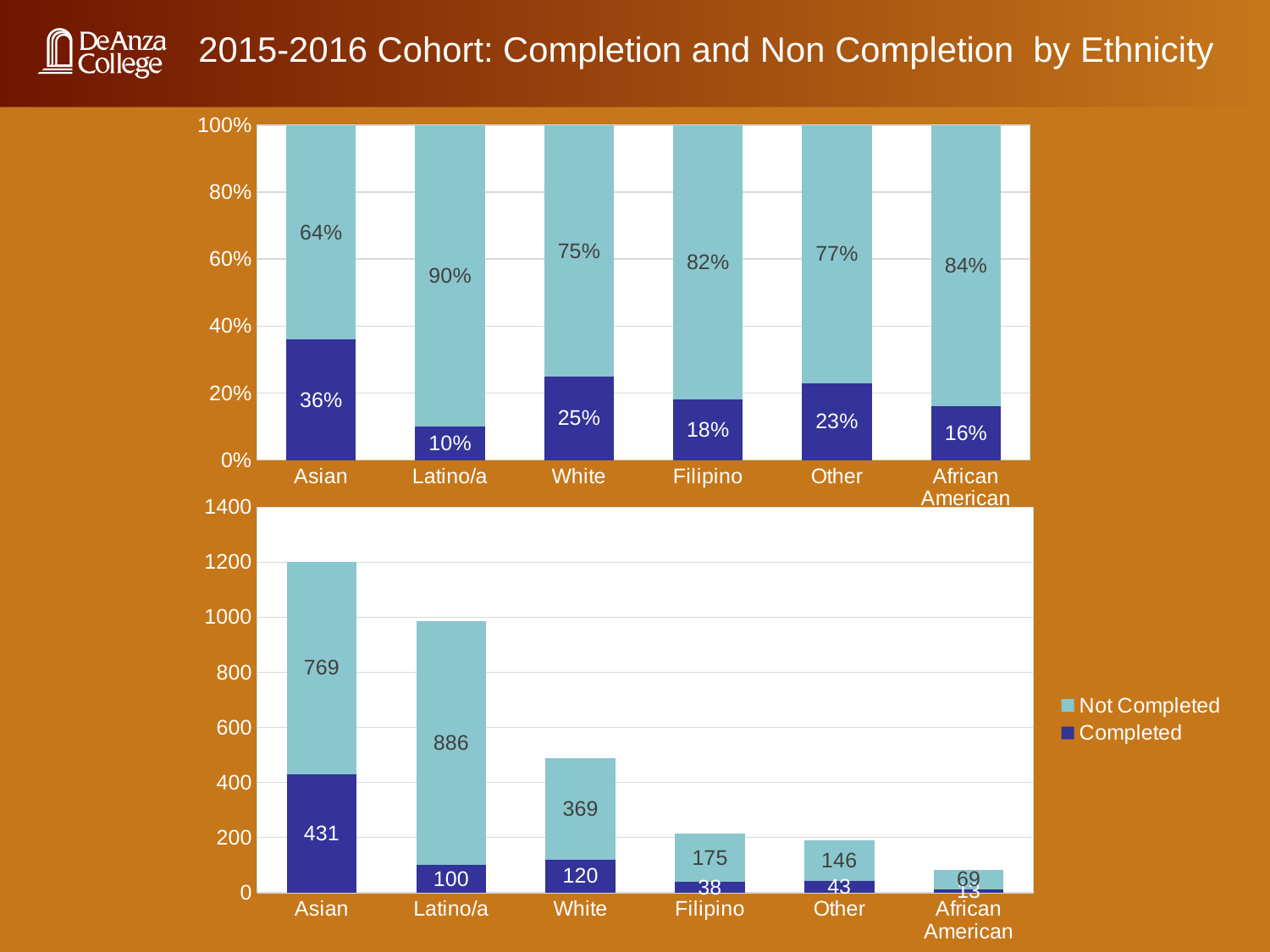
In the bottom chart, is the Completed count for White larger or smaller than the Completed count for Filipino? larger In the top chart, what is the Not Completed percentage for Latino/a? 90% In the top chart, which ethnicity has the lowest Completed percentage? Latino/a In the top chart, which ethnicity has the highest Completed percentage? Asian In the bottom chart, how many Asian students are in the Not Completed group? 769 In the bottom chart, which ethnicity has the largest Not Completed count? Latino/a How many ethnicity categories are shown on the x axis of the bottom chart? 6 In the top chart, what is the Completed percentage for Asian? 36% In the bottom chart, what is the total number of Asian students (Completed plus Not Completed)? 1200 In the top chart, what is the difference between the Not Completed percentages for African American and White? 9% How many series does the legend list? 2 In the bottom chart, how many Latino/a students are in the Completed group? 100